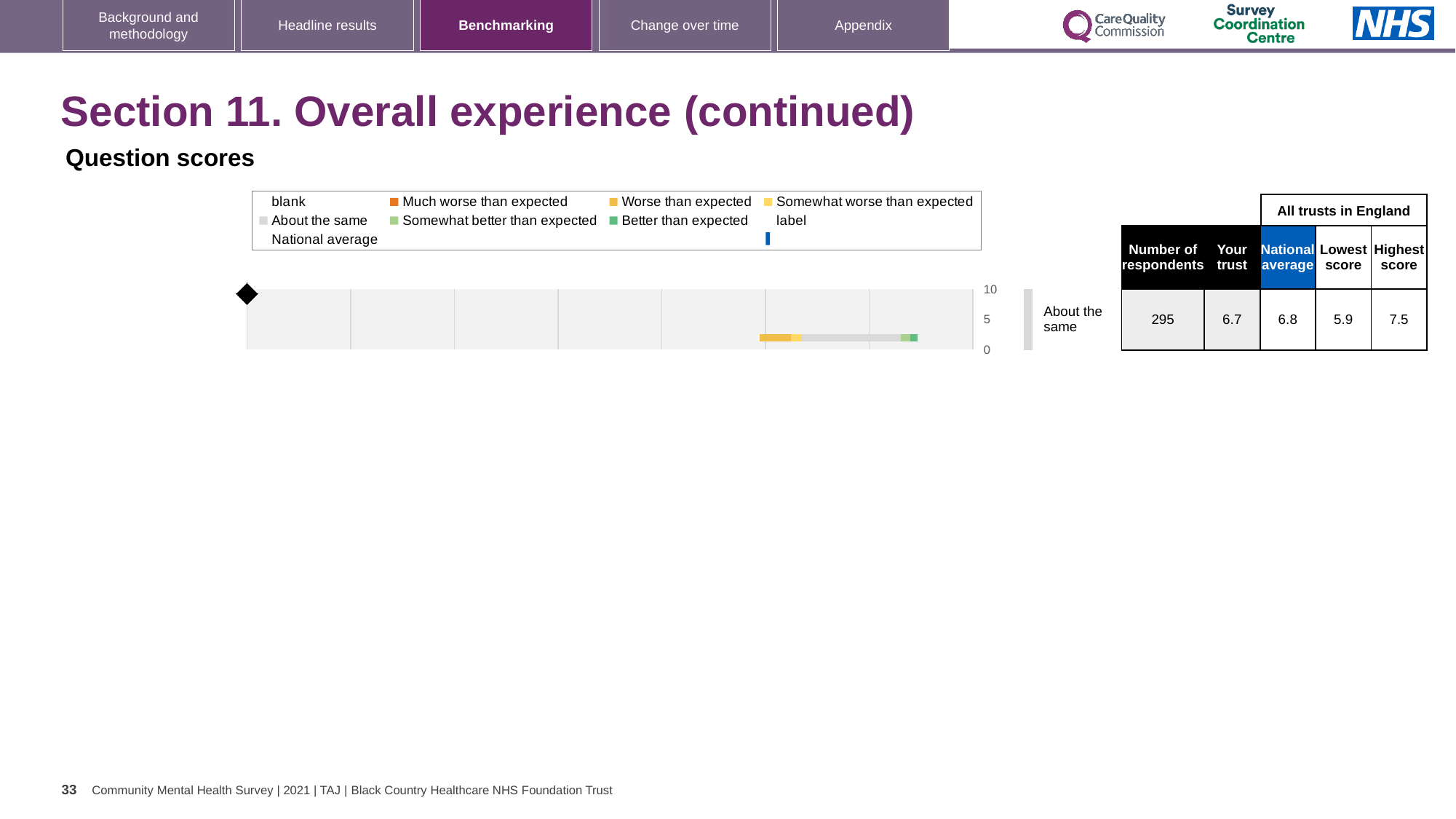
What is the Highest score among all trusts in England shown on the slide? 7.5 Which is larger, the 'Your trust' score or the National average score? National average How many respondents are shown for the 'About the same' row? 295 What kind of chart is shown on the slide? bar chart What is the 'Your trust' score for the 'About the same' row? 6.7 What is the difference between the Highest score and the Lowest score shown? 1.6 What is the difference between the National average and the 'Your trust' score? 0.1 What is the National average score shown for the 'About the same' row? 6.8 Is the 'Your trust' score greater or less than 5? greater What is the highest value shown on the chart's vertical axis? 10 What is the Lowest score among all trusts in England shown on the slide? 5.9 What benchmark category label is shown next to the chart's bar? About the same